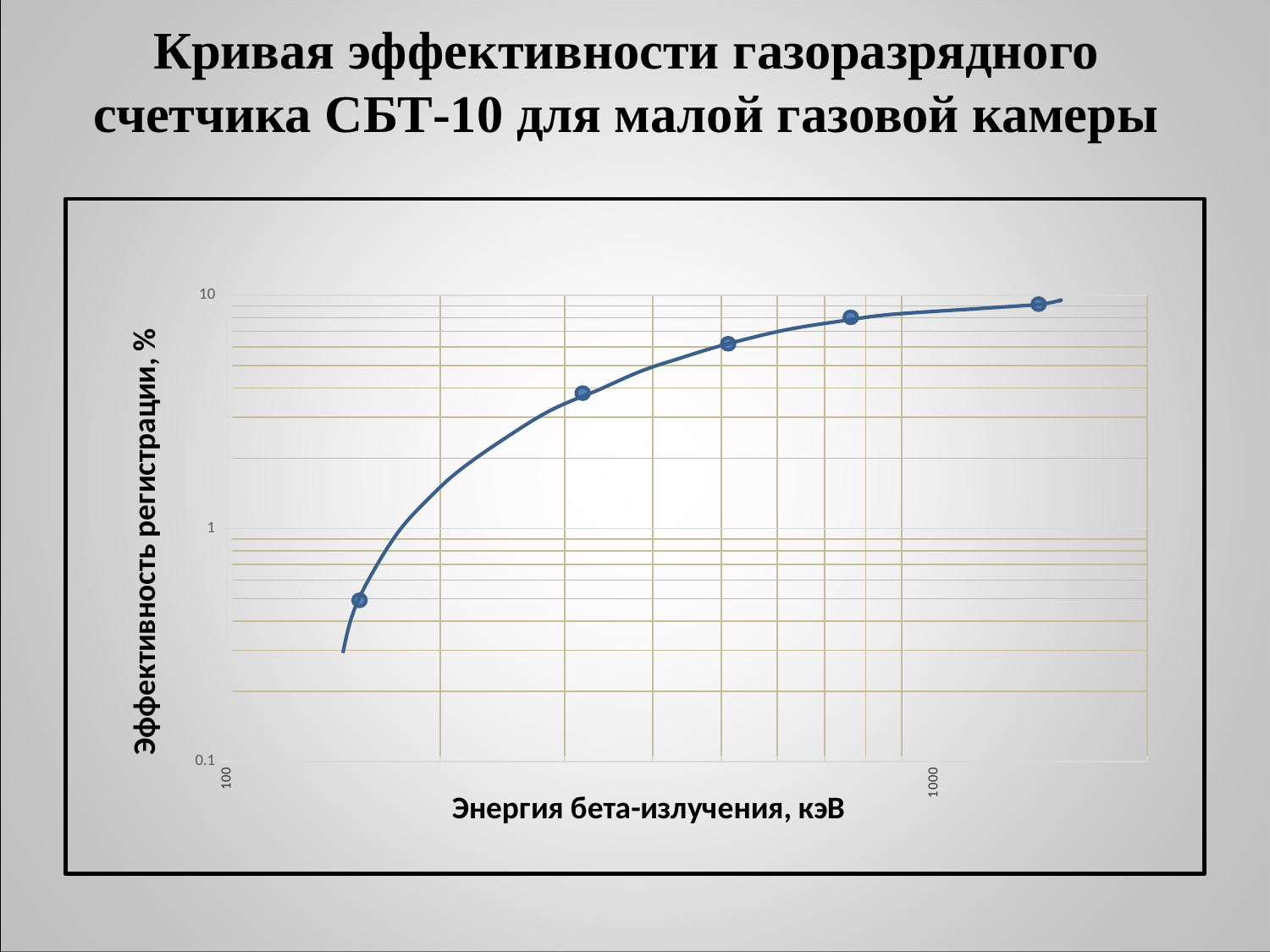
Does the registration efficiency rise or fall as the beta-radiation energy increases along the x axis? rises Is the efficiency value of the second data point from the left greater or less than 1? greater Which is larger: the efficiency of the second point from the left or the efficiency of the leftmost point? the second point from the left Which data point has the highest registration efficiency: the leftmost or the rightmost? the rightmost How many data points are plotted on the chart? 5 What kind of chart is shown on the slide? line chart Is the efficiency value of the rightmost (highest-energy) data point greater or less than 1? greater Which data point has the lowest registration efficiency: the leftmost or the rightmost? the leftmost What is the title of the x axis of the chart? Энергия бета-излучения, кэВ What is the title of the y axis of the chart? Эффективность регистрации, % Is the efficiency value of the leftmost (lowest-energy) data point greater or less than 1? less